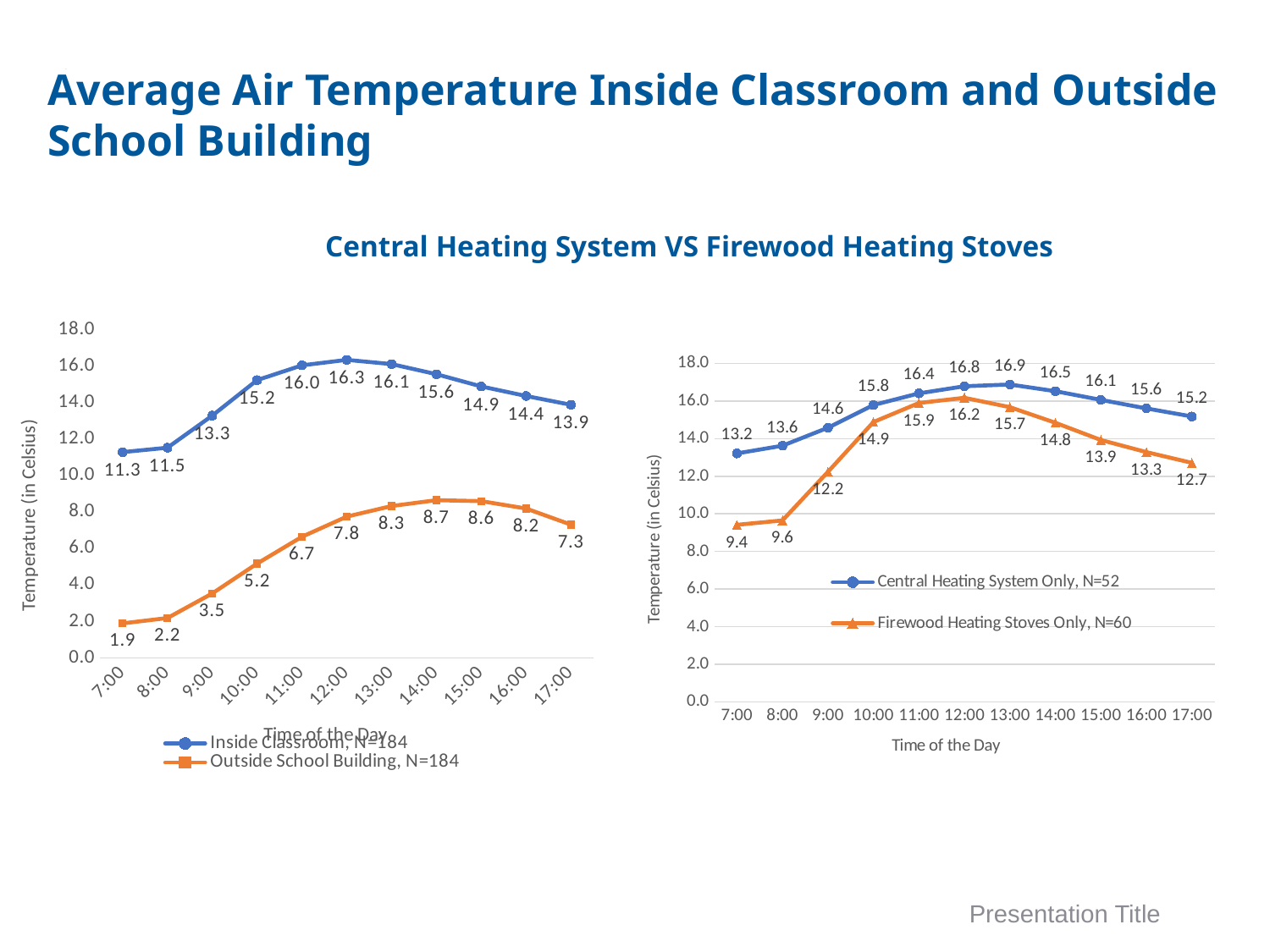
On the left chart, at what time of day is the Inside Classroom temperature lowest? 7:00 On the right chart, at what time of day does the Firewood Heating Stoves Only series peak? 12:00 On the left chart, what is the Inside Classroom temperature at 12:00? 16.3 On the left chart, what is the difference between the Inside Classroom and Outside School Building temperatures at 10:00? 10.0 On the left chart, at what time of day does the Outside School Building series reach its highest value? 14:00 What type of chart is the right chart? Line chart On the right chart, what is the Firewood Heating Stoves Only temperature at 9:00? 12.2 On the right chart, what is the Central Heating System Only temperature at 13:00? 16.9 On the right chart, which series has the higher value at 8:00, Central Heating System Only or Firewood Heating Stoves Only? Central Heating System Only On the left chart, what is the Outside School Building temperature at 7:00? 1.9 How many time points are plotted along the x axis of the right chart? 11 How many series does the legend of the left chart list? 2